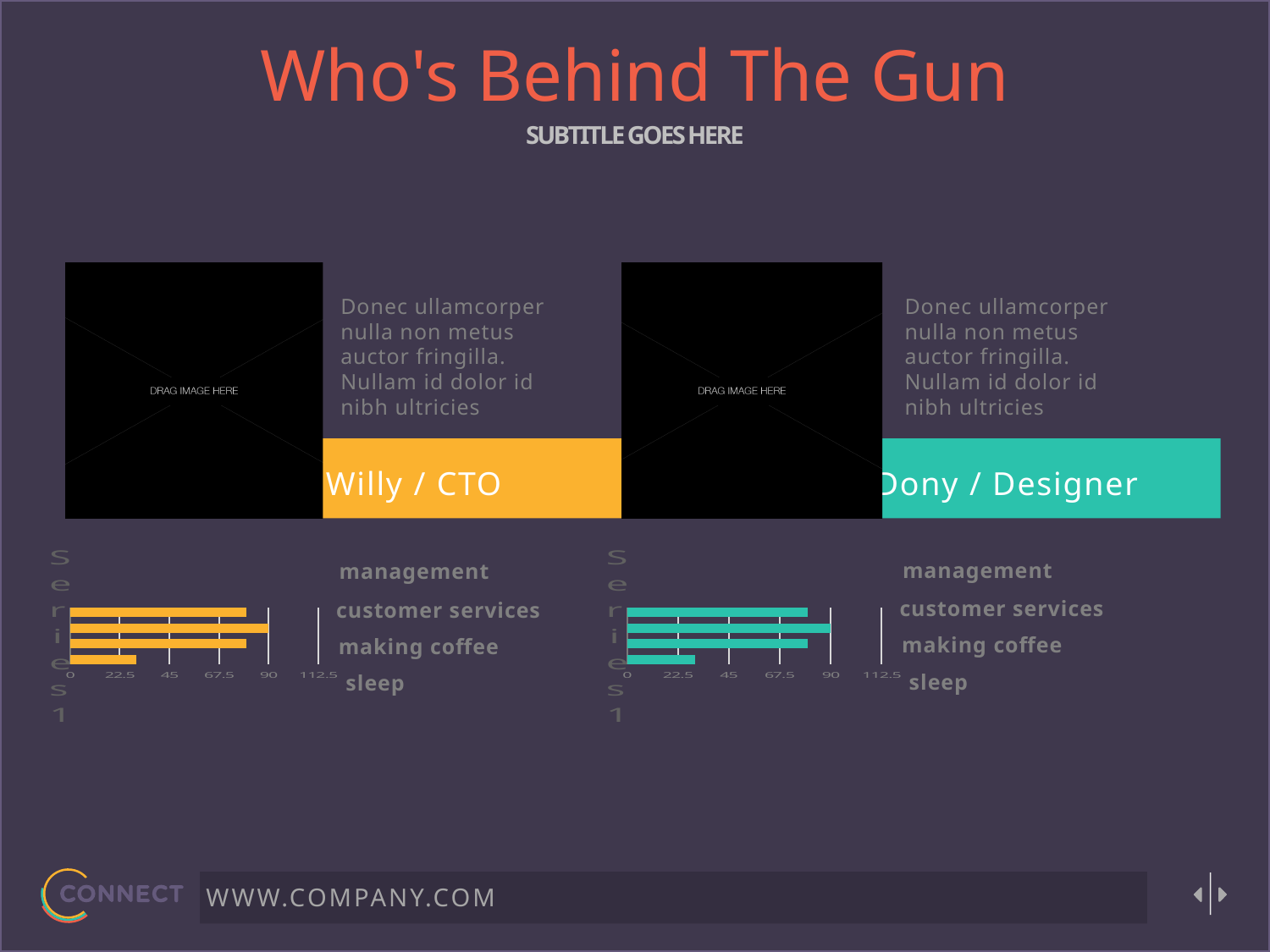
In the left chart (under Willy / CTO), is the value of the bottom bar greater or less than 45? less In the left chart (under Willy / CTO), which bar is the shortest? the bottom bar In the right chart (under Dony / Designer), which bar is the longest? the second bar from the top In the left chart (under Willy / CTO), is the value of the top bar greater or less than 67.5? greater What type of chart is shown under Willy / CTO on the left? bar chart What is the highest tick value shown on the horizontal axis of the right chart (under Dony / Designer)? 112.5 In the right chart (under Dony / Designer), is the value of the bottom bar greater or less than 45? less In the left chart (under Willy / CTO), which is larger: the top bar or the bottom bar? the top bar How many bars does the left chart (under Willy / CTO) have? 4 What colour are the bars in the right chart (under Dony / Designer)? teal How many bars does the right chart (under Dony / Designer) have? 4